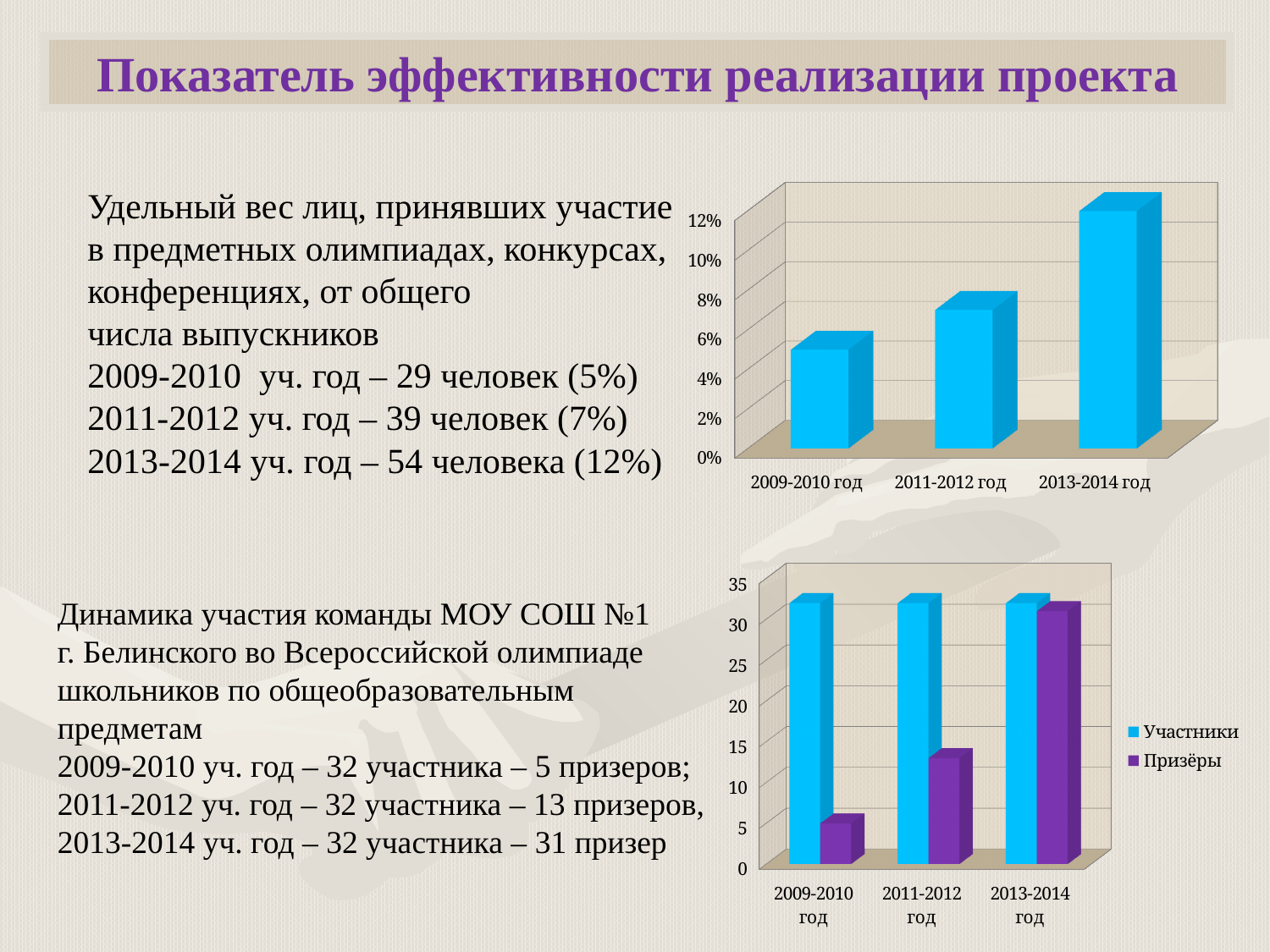
What kind of chart is the top chart on the slide? bar chart In the top chart, what is the value for 2013-2014 год? 12% In the top chart, which year has the highest value? 2013-2014 год In the top chart, is the value for 2009-2010 год greater or less than 6%? less How many series does the legend of the bottom chart list? 2 In the top chart, do the values rise or fall from 2009-2010 год to 2013-2014 год? rise In the top chart, which year has the lowest value? 2009-2010 год In the bottom chart, which series is shown in purple? Призёры In the top chart, is the value for 2011-2012 год greater or less than 6%? greater In the top chart, how many categories are shown on the x axis? 3 In the bottom chart, is the value of Призёры for 2011-2012 год greater or less than 10? greater In the bottom chart, what is the value of Призёры for 2009-2010 год? 5